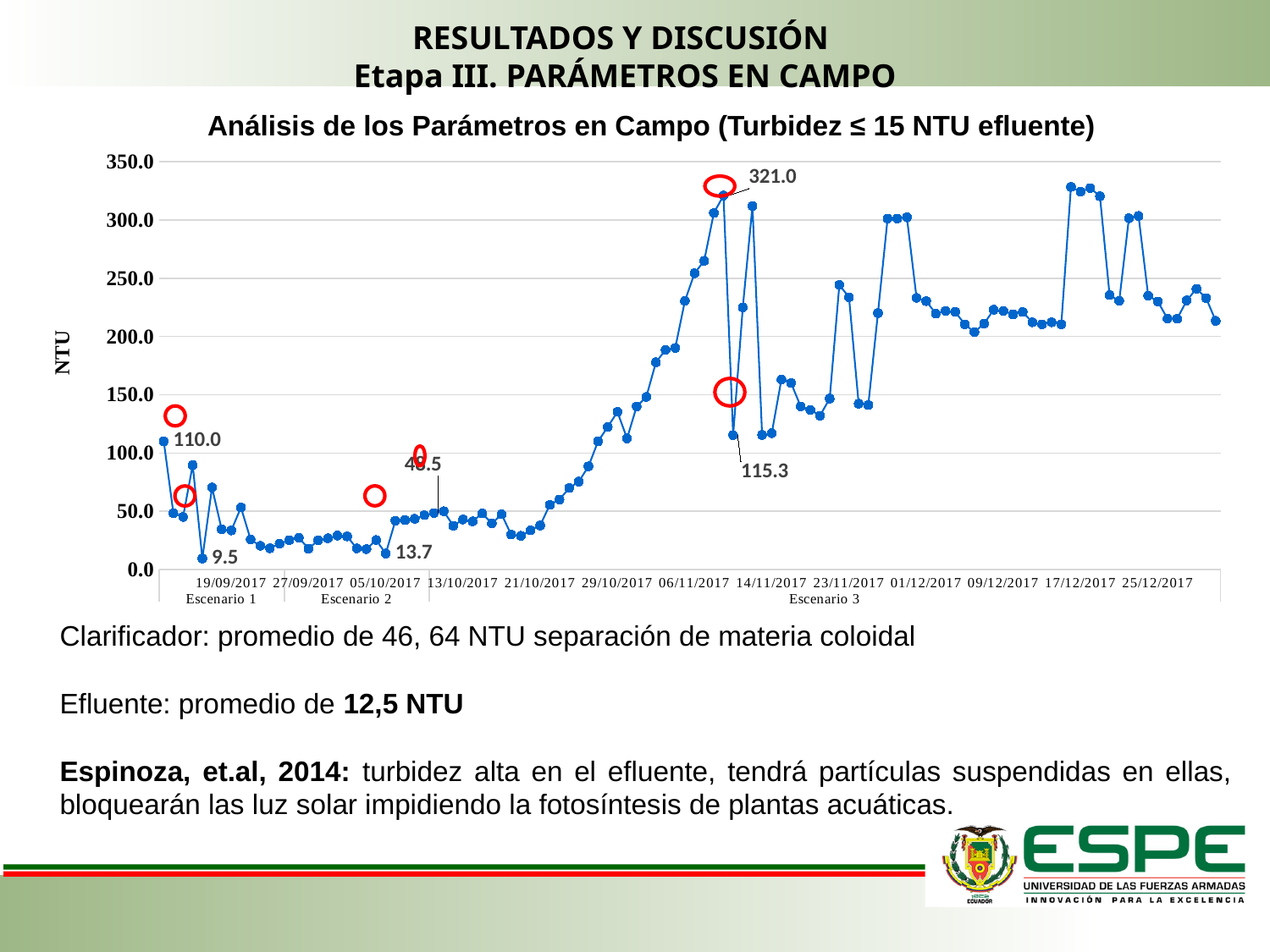
What is the lowest value labeled on the chart? 9.5 How many scenarios (Escenarios) are labeled along the x axis? 3 What is the highest value labeled on the chart? 321.0 Which labeled value is larger, 110.0 or 115.3? 115.3 What is the label on the vertical axis of the chart? NTU What kind of chart is shown on the slide? line chart Do the values generally rise or fall from the end of Escenario 2 into Escenario 3? rise What is the difference between the labeled values 321.0 and 115.3? 205.7 What is the difference between the labeled values 110.0 and 9.5? 100.5 What is the title of the chart? Análisis de los Parámetros en Campo (Turbidez ≤ 15 NTU efluente) Are the values plotted in Escenario 2 greater or less than 100.0? less